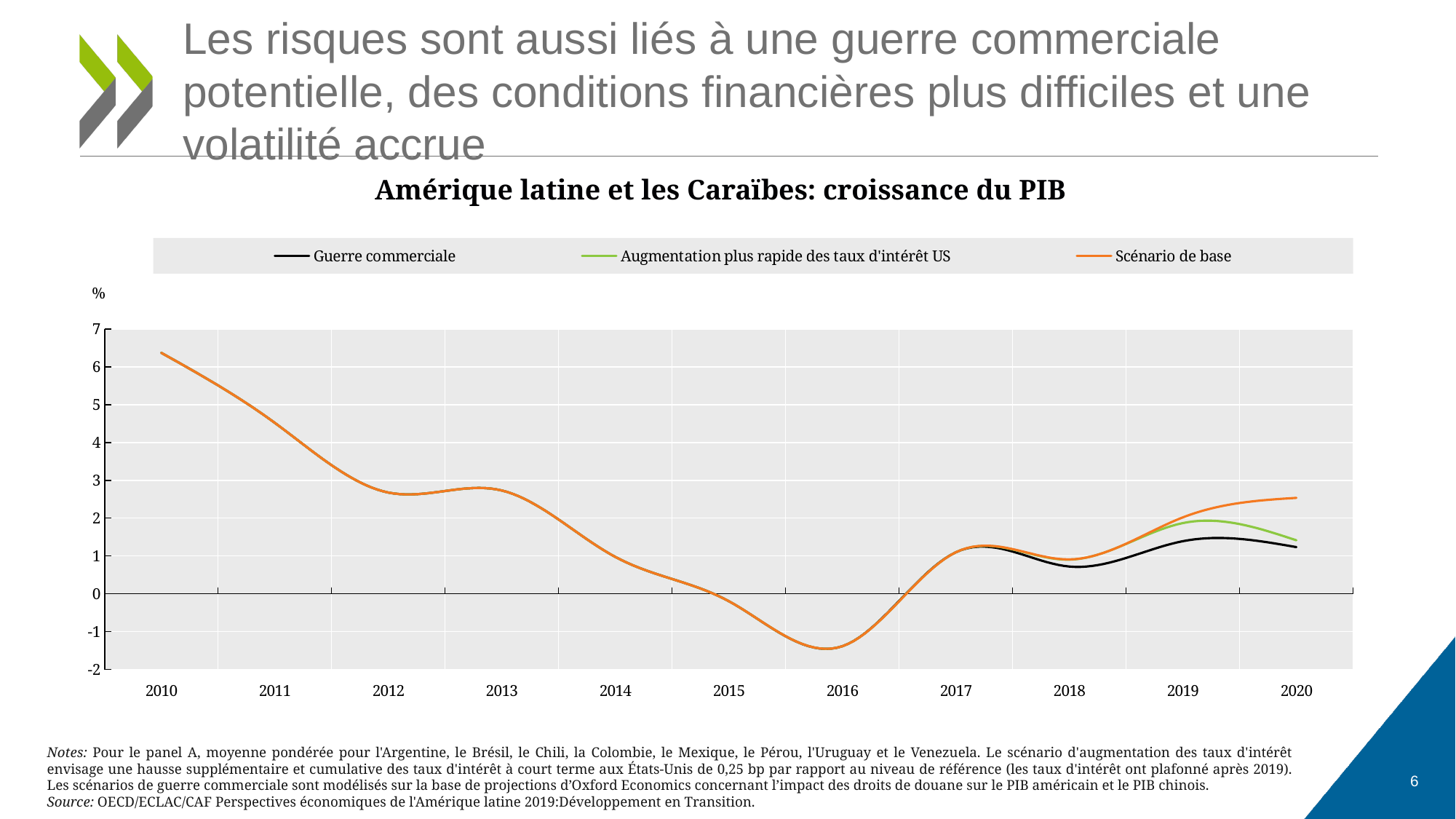
What colour is the line for 'Scénario de base'? orange Is the value for 'Guerre commerciale' in 2020 greater or less than 2? less What kind of chart is shown on the slide? line chart How many series does the legend list? 3 Which labelled year has the highest value? 2010 Is the value for 2010 greater or less than 5? greater How many years are labelled on the x axis? 11 What is the title of the chart? Amérique latine et les Caraïbes: croissance du PIB Is the value for 2013 greater or less than 2? greater In 2020, which is higher: 'Scénario de base' or 'Guerre commerciale'? Scénario de base Do the values rise or fall from 2010 to 2016? fall